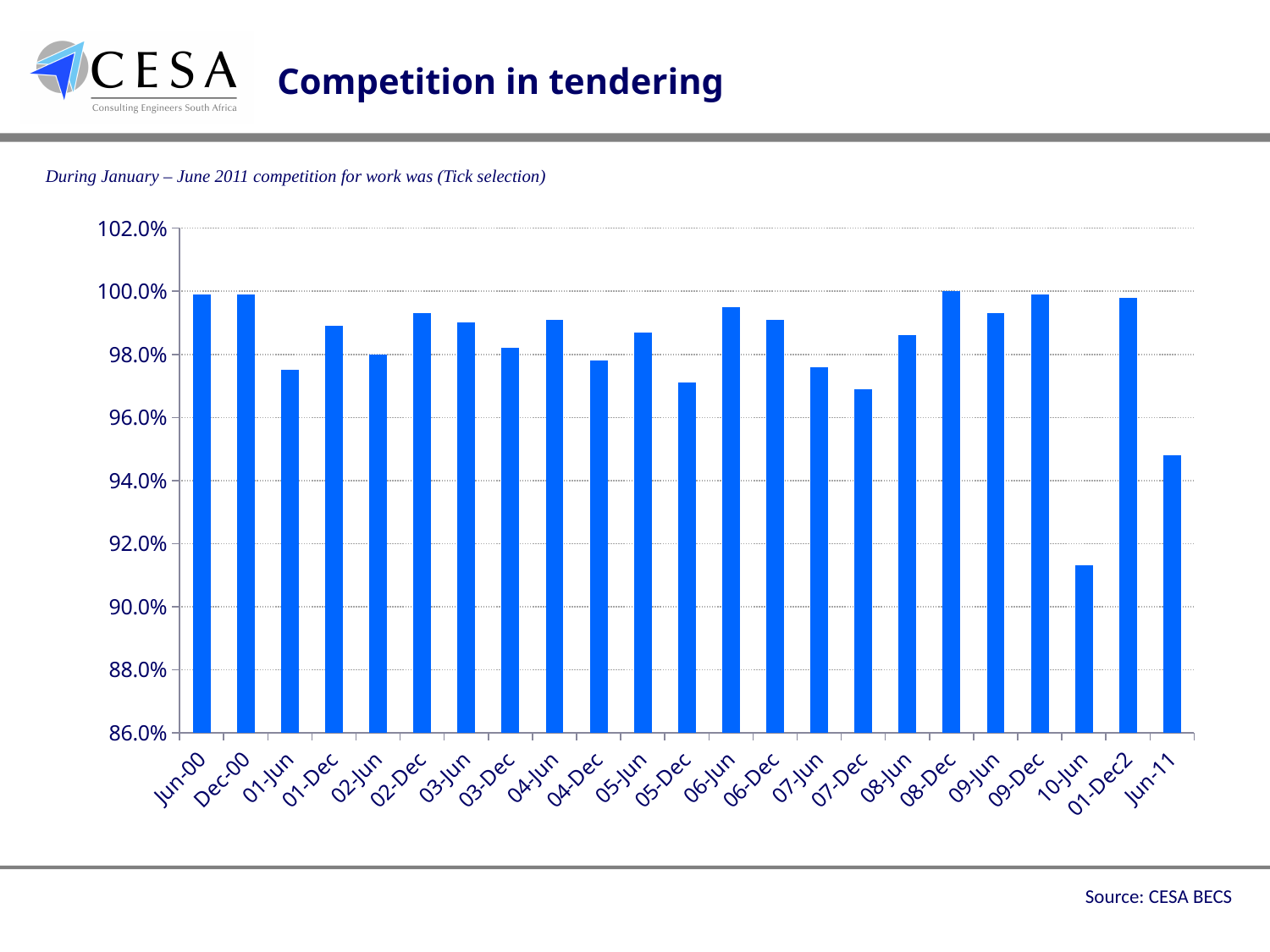
Is the value for 10-Jun greater or less than 92.0%? less Which is larger, the value for 01-Jun or the value for 01-Dec? 01-Dec Which is larger, the value for 07-Dec or the value for 08-Jun? 08-Jun What kind of chart is shown on the slide? bar chart What is the highest value shown on the vertical axis of the chart? 102.0% Which is larger, the value for 10-Jun or the value for Jun-11? Jun-11 Is the value for Jun-11 greater or less than 94.0%? greater Is the value for 05-Dec greater or less than 98.0%? less Which period has the lowest value in the chart? 10-Jun How many bars (periods) are plotted in the chart? 23